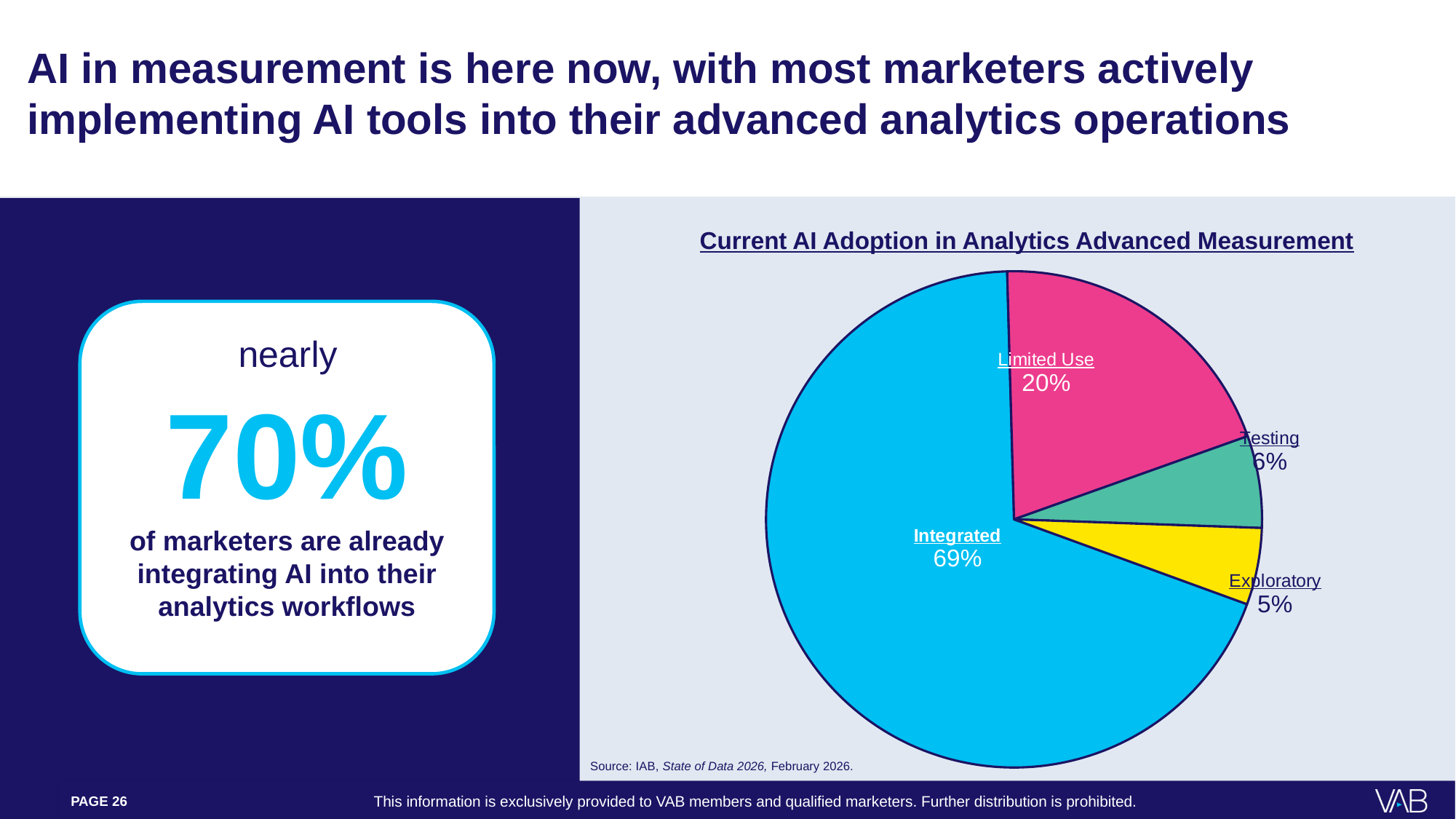
Which slice of the pie chart is the largest? Integrated What percentage of the pie is labelled Limited Use? 20% Which slice of the pie chart is the smallest? Exploratory What percentage of the pie is labelled Testing? 6% What percentage of the pie is labelled Exploratory? 5% What is the title of the pie chart? Current AI Adoption in Analytics Advanced Measurement What is the combined share of the Testing and Exploratory slices? 11% Which is larger, the Testing slice or the Exploratory slice? Testing What percentage of the pie is labelled Integrated? 69% What kind of chart is shown on the slide? Pie chart What is the difference in percentage points between the Integrated and Limited Use slices? 49 How many slices does the pie chart have? 4